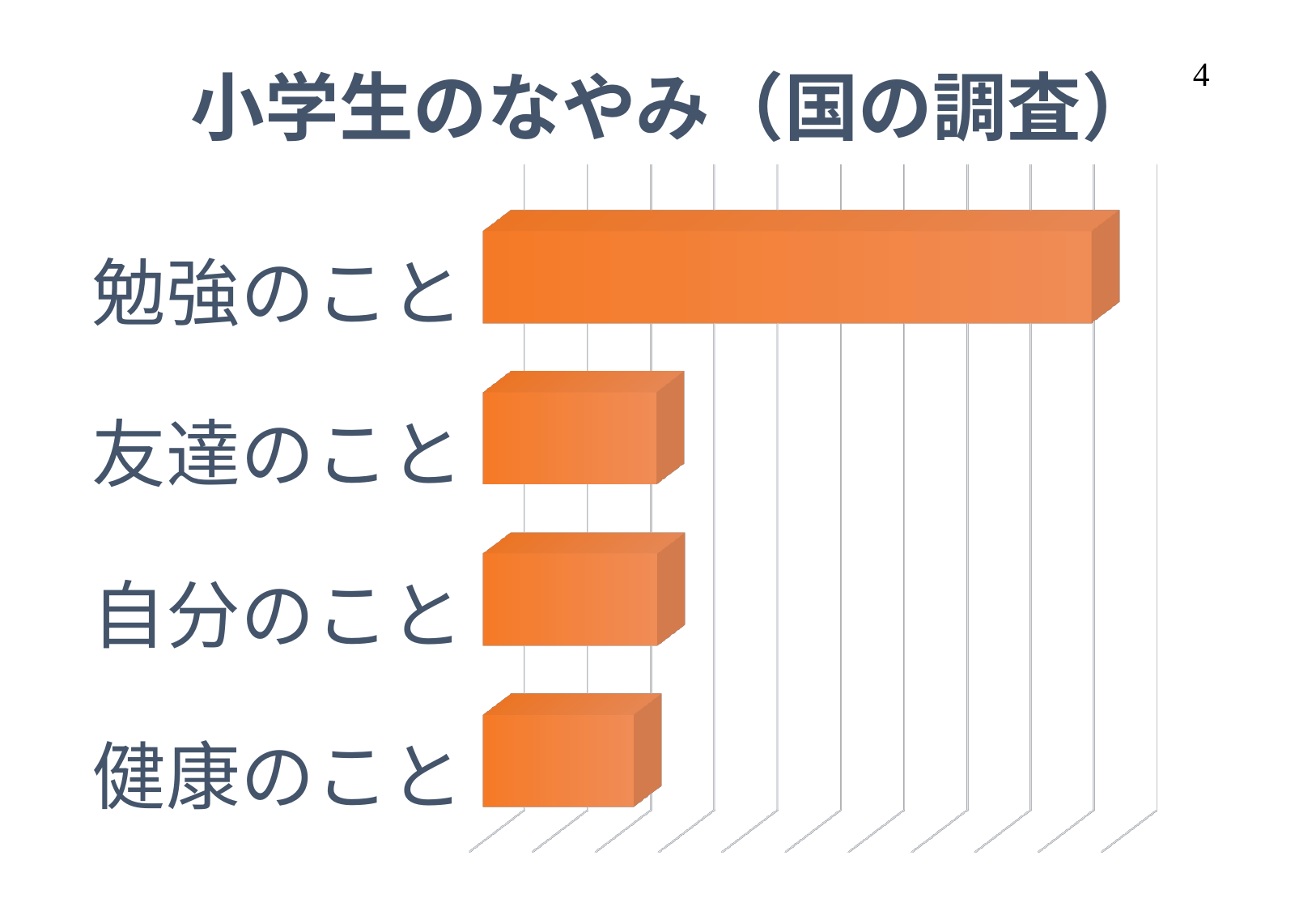
Which is larger, the value for 自分のこと or the value for 勉強のこと? 勉強のこと Which is larger, the value for 勉強のこと or the value for 健康のこと? 勉強のこと What kind of chart is shown on the slide? bar chart Which is larger, the value for 勉強のこと or the value for 友達のこと? 勉強のこと Which category has the longest bar? 勉強のこと How many categories are plotted in the chart? 4 What is the category label of the top bar in the chart? 勉強のこと What is the title of the chart? 小学生のなやみ（国の調査） Which category is listed at the bottom of the chart? 健康のこと